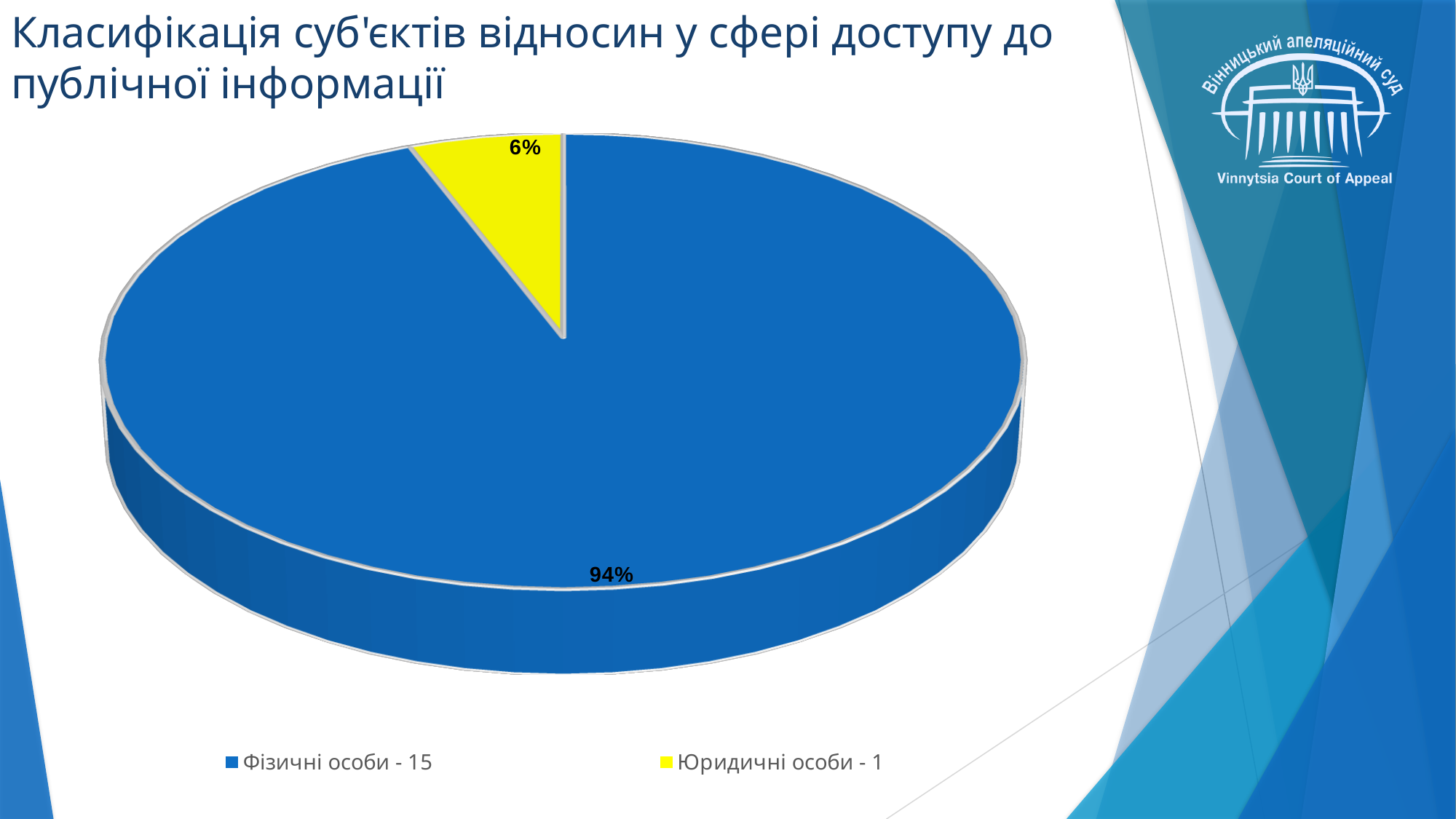
What percentage share does the slice for Юридичні особи have? 6% What kind of chart is shown on the slide? Pie chart Which category has the largest slice of the pie? Фізичні особи How many slices does the pie chart have? 2 Which category has the smallest slice of the pie? Юридичні особи What colour is the slice for Юридичні особи? Yellow Which slice is larger, Фізичні особи or Юридичні особи? Фізичні особи What is the difference in percentage points between the Фізичні особи slice and the Юридичні особи slice? 88 What count is shown in the legend for Юридичні особи? 1 What percentage share does the slice for Фізичні особи have? 94% How many entries does the legend list? 2 What count is shown in the legend for Фізичні особи? 15